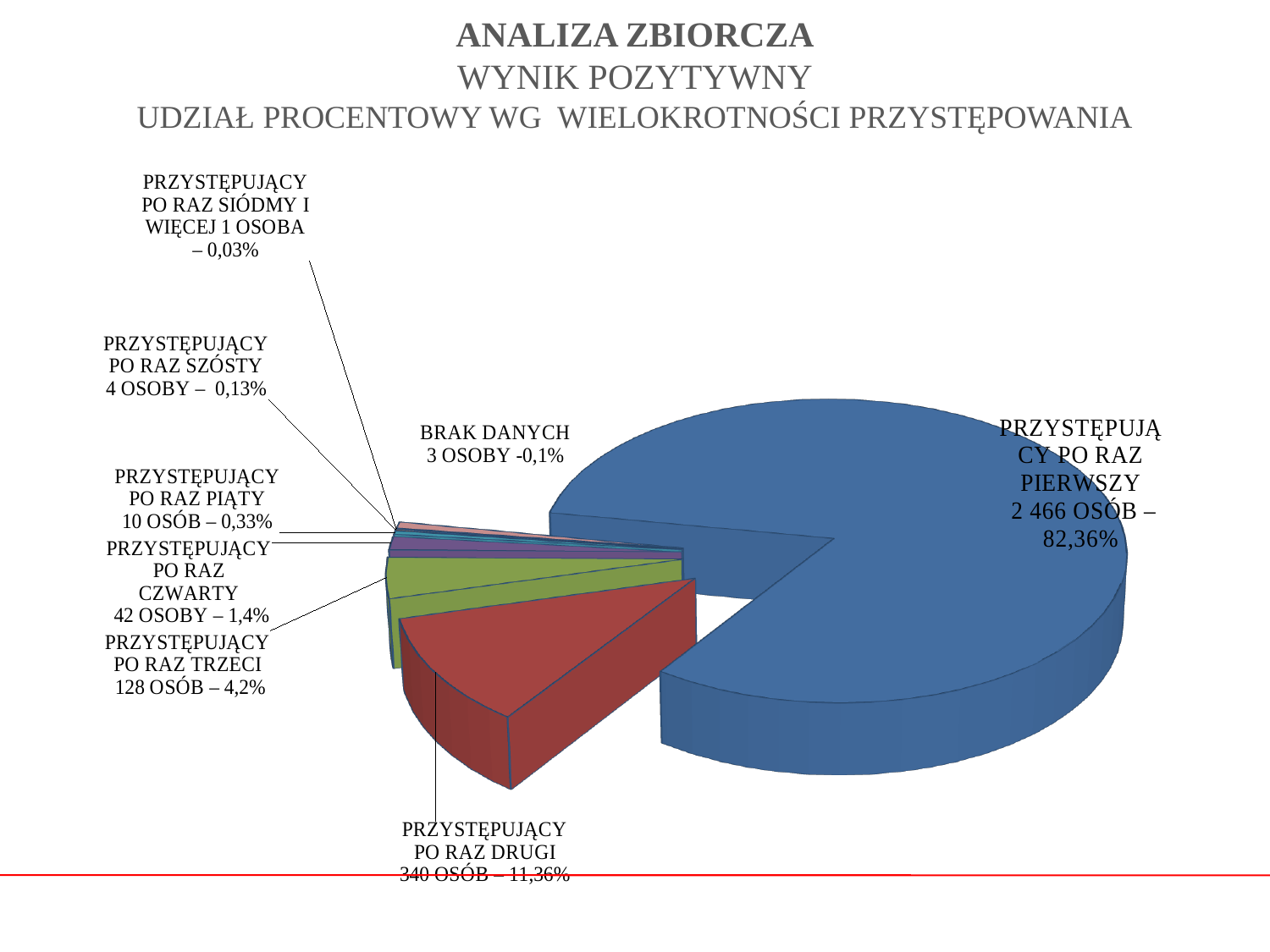
What percentage share is shown for PRZYSTĘPUJĄCY PO RAZ TRZECI? 4,2% Which has a larger share: PRZYSTĘPUJĄCY PO RAZ PIĄTY or PRZYSTĘPUJĄCY PO RAZ SZÓSTY? PRZYSTĘPUJĄCY PO RAZ PIĄTY What percentage share is shown for PRZYSTĘPUJĄCY PO RAZ PIERWSZY? 82,36% How many people are shown for PRZYSTĘPUJĄCY PO RAZ DRUGI? 340 OSÓB What percentage share is shown for BRAK DANYCH? 0,1% What is the difference in number of people between PRZYSTĘPUJĄCY PO RAZ DRUGI and PRZYSTĘPUJĄCY PO RAZ TRZECI? 212 What kind of chart is shown on the slide? pie chart Which category has the smallest share of the pie? PRZYSTĘPUJĄCY PO RAZ SIÓDMY I WIĘCEJ How many slices does the pie chart have? 8 Which category has the largest share of the pie? PRZYSTĘPUJĄCY PO RAZ PIERWSZY What colour is the slice for PRZYSTĘPUJĄCY PO RAZ DRUGI? red How many people are shown for PRZYSTĘPUJĄCY PO RAZ CZWARTY? 42 OSOBY